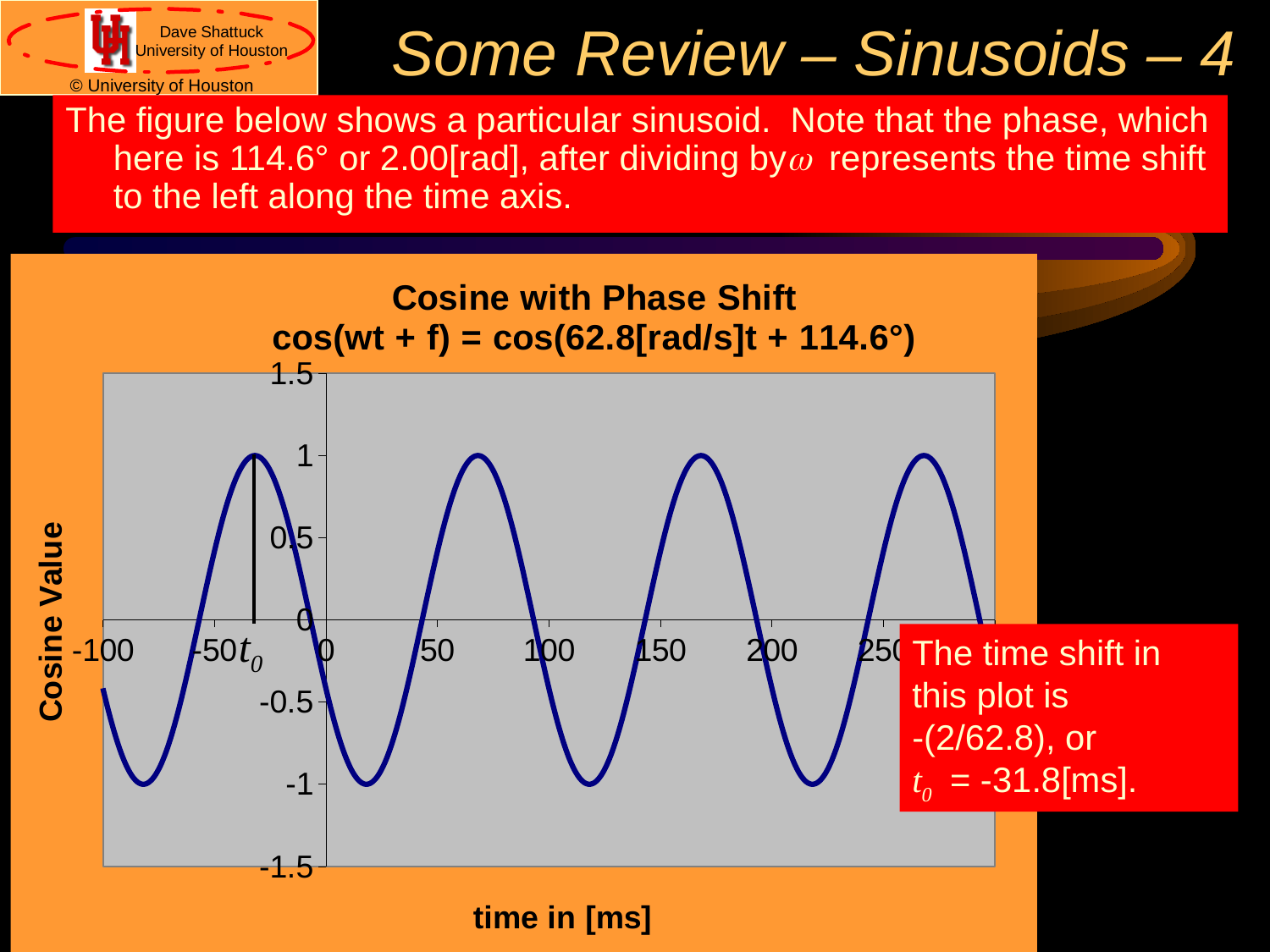
What is the value of the time shift t0 marked on the chart? -31.8[ms] What is the difference between the maximum and minimum values of the plotted curve? 2 What is the highest tick value shown on the y axis? 1.5 What is the title of the chart? Cosine with Phase Shift cos(wt + f) = cos(62.8[rad/s]t + 114.6°) What is the maximum value reached by the plotted cosine curve? 1 How many peaks (maxima) of the curve are visible in the plotted range? 4 What kind of chart is shown on the slide? line chart Is the value of the curve at time 100 ms greater or less than 0? less Is the value of the curve at time 0 ms greater or less than 0? less Is the value of the curve at time -100 ms greater or less than 0? less What is the minimum value reached by the plotted cosine curve? -1 What is the label of the x axis of the chart? time in [ms]